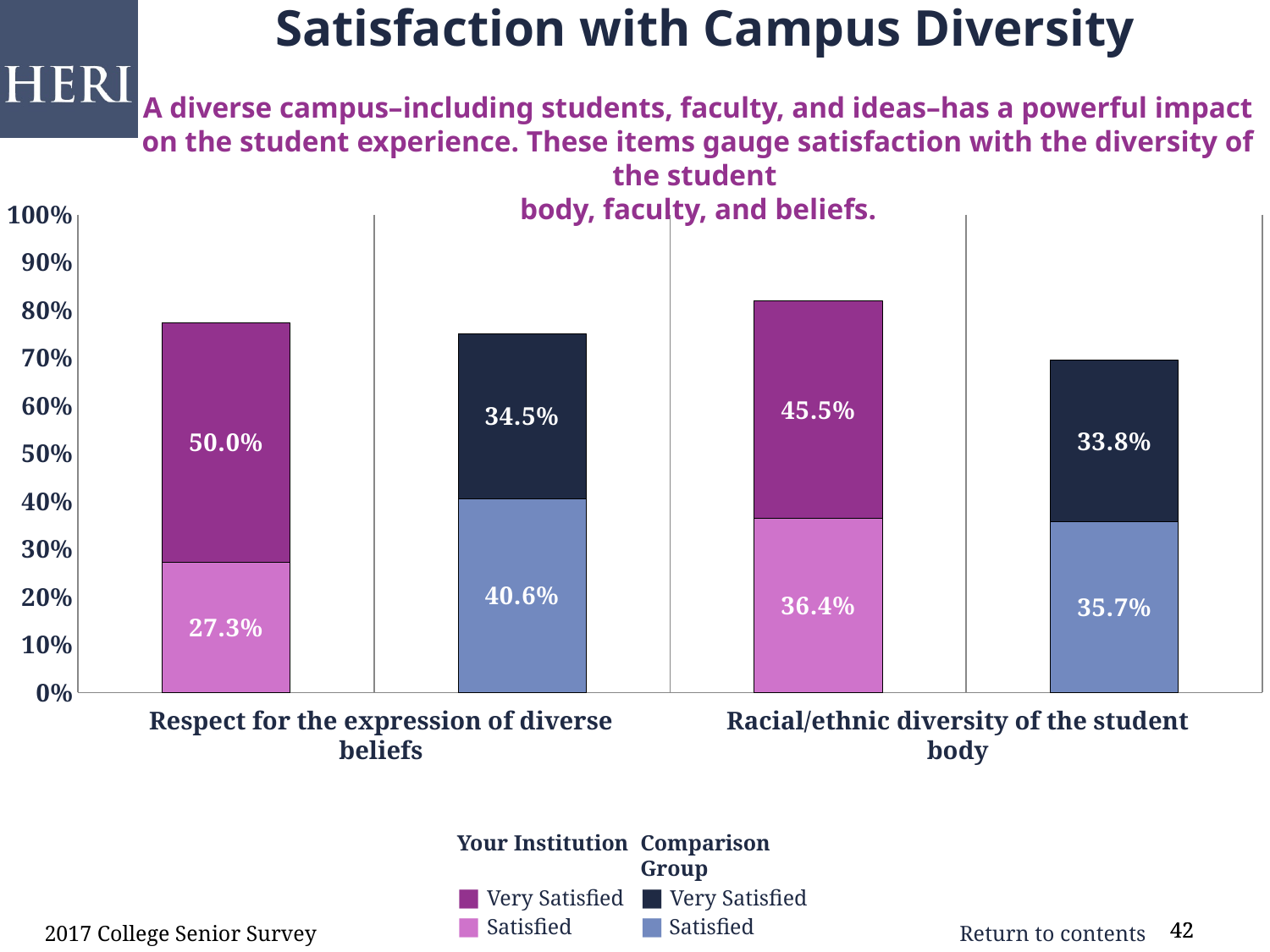
What percentage of Your Institution students were Very Satisfied with respect for the expression of diverse beliefs? 50.0% Which is larger: the Comparison Group's Satisfied value for respect for the expression of diverse beliefs or its Very Satisfied value for the same item? Satisfied (40.6%) How many categories are shown on the x axis? 2 What is the total of the Comparison Group stacked bar for racial/ethnic diversity of the student body? 69.5% What percentage of the Comparison Group were Satisfied with racial/ethnic diversity of the student body? 35.7% What kind of chart is shown on the slide? Stacked bar chart Which stacked bar has the highest total on the chart? Your Institution, Racial/ethnic diversity of the student body What is the total of the Your Institution stacked bar for respect for the expression of diverse beliefs? 77.3% What is the difference between the Very Satisfied percentages for Your Institution and the Comparison Group on respect for the expression of diverse beliefs? 15.5% Which segment has the lowest value on the chart? Your Institution Satisfied, Respect for the expression of diverse beliefs (27.3%) What percentage of Your Institution students were Satisfied with racial/ethnic diversity of the student body? 36.4% How many series does the legend list? 4